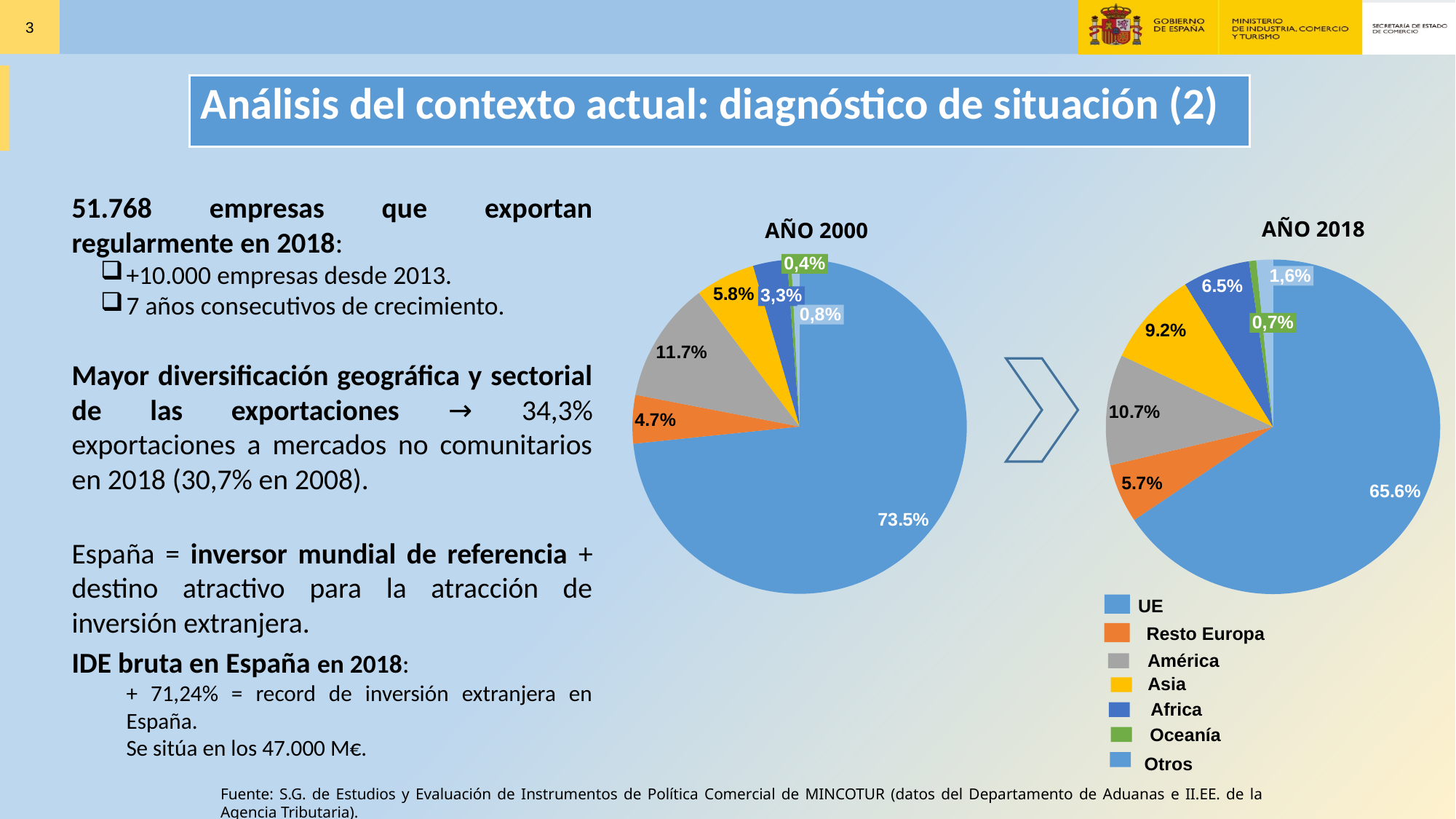
In the AÑO 2018 pie chart, what share of exports went to the UE? 65.6% In the pie charts, which colour represents Resto Europa? Orange In the AÑO 2000 pie chart, which category has the smallest share? Oceanía In the AÑO 2000 pie chart, what share of exports went to the UE? 73.5% What type of chart is used to show the AÑO 2000 and AÑO 2018 export distributions? Pie chart How many categories does the legend list for the pie charts? 7 What is the difference between the UE share in the AÑO 2000 chart and the UE share in the AÑO 2018 chart? 7.9% In the AÑO 2018 pie chart, what is the value for Africa? 6.5% In the AÑO 2000 pie chart, what is the value for América? 11.7% In the AÑO 2018 pie chart, which category has the largest share? UE In the AÑO 2018 pie chart, what is the value for Asia? 9.2% In the AÑO 2018 pie chart, which is larger: the share for América or the share for Asia? América